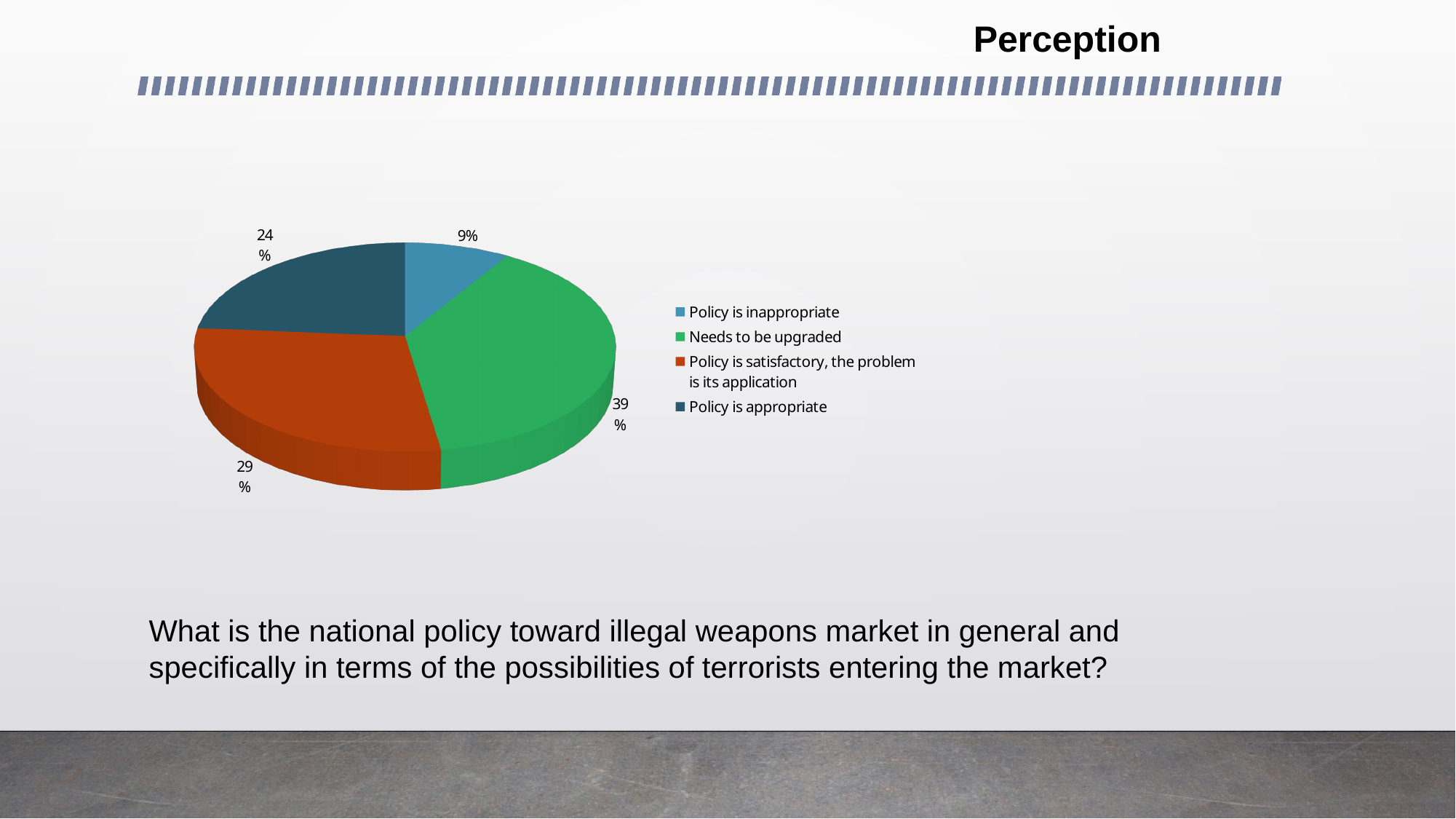
How many slices does the pie chart have? 4 What kind of chart is shown on the slide? pie chart Which response has the smallest share of the pie? Policy is inappropriate Which is larger: the share for 'Policy is satisfactory, the problem is its application' or the share for 'Policy is appropriate'? Policy is satisfactory, the problem is its application What percentage of respondents said the policy is satisfactory, the problem is its application? 29% What percentage of respondents said the policy needs to be upgraded? 39% What percentage of respondents said the policy is appropriate? 24% Which response has the largest share of the pie? Needs to be upgraded What is the combined share of 'Policy is inappropriate' and 'Needs to be upgraded'? 48% What percentage of respondents said the policy is inappropriate? 9% What is the difference in percentage points between 'Needs to be upgraded' and 'Policy is appropriate'? 15 What colour is the slice for 'Needs to be upgraded'? green